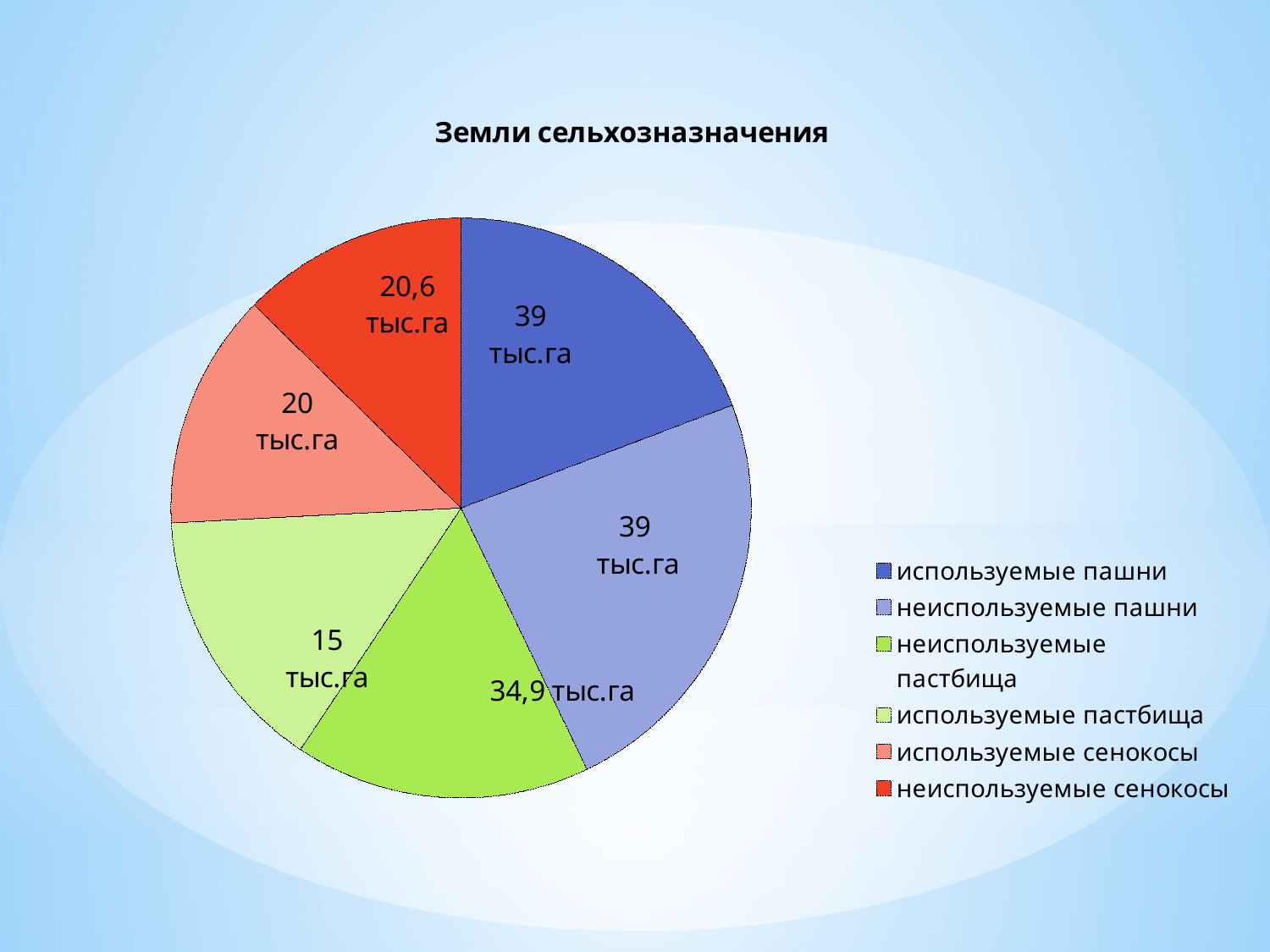
What is the difference between неиспользуемые сенокосы and используемые сенокосы? 0,6 тыс.га What is the value for используемые пашни? 39 тыс.га Which is larger, неиспользуемые пашни or неиспользуемые пастбища? неиспользуемые пашни What kind of chart is shown on the slide? pie chart What is the value for используемые сенокосы? 20 тыс.га Which category is shown in red? неиспользуемые сенокосы What is the value for неиспользуемые сенокосы? 20,6 тыс.га What is the difference between используемые пашни and используемые пастбища? 24 тыс.га How many categories does the pie chart show? 6 What is the value for неиспользуемые пастбища? 34,9 тыс.га What is the title of the chart? Земли сельхозназначения